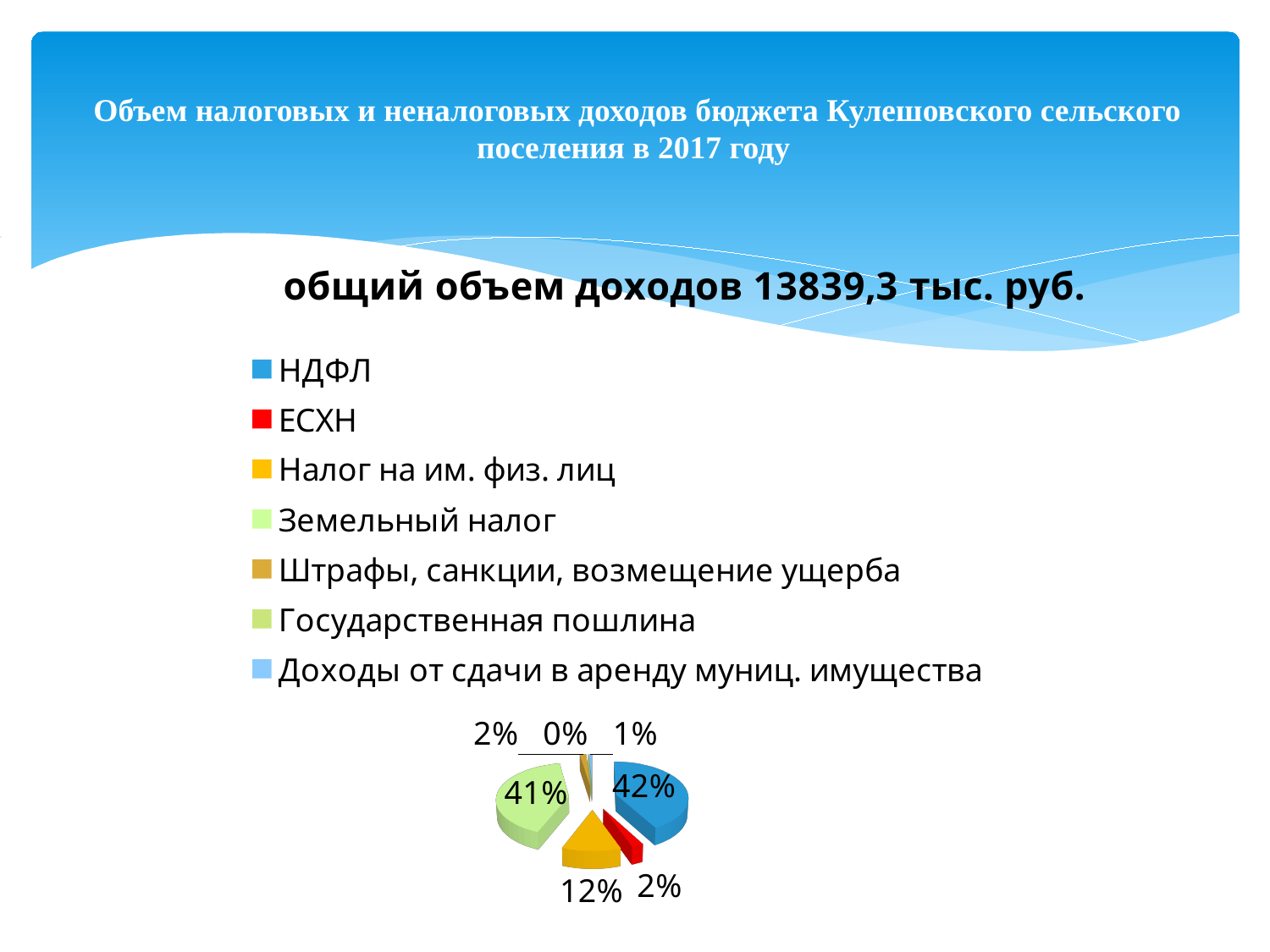
How many categories does the legend list? 7 What kind of chart is shown on the slide? pie chart What share of the pie does Налог на им. физ. лиц account for? 12% What total revenue amount is stated above the chart? 13839,3 тыс. руб. What share of the pie does НДФЛ account for? 42% What is the difference in percentage points between the shares of НДФЛ and Налог на им. физ. лиц? 30 What share of the pie does ЕСХН account for? 2% Which category has the smallest share of the pie? Государственная пошлина What share of the pie does Государственная пошлина account for? 0% What share of the pie does Земельный налог account for? 41% Which has the larger share, Земельный налог or Налог на им. физ. лиц? Земельный налог Which category has the largest share of the pie? НДФЛ